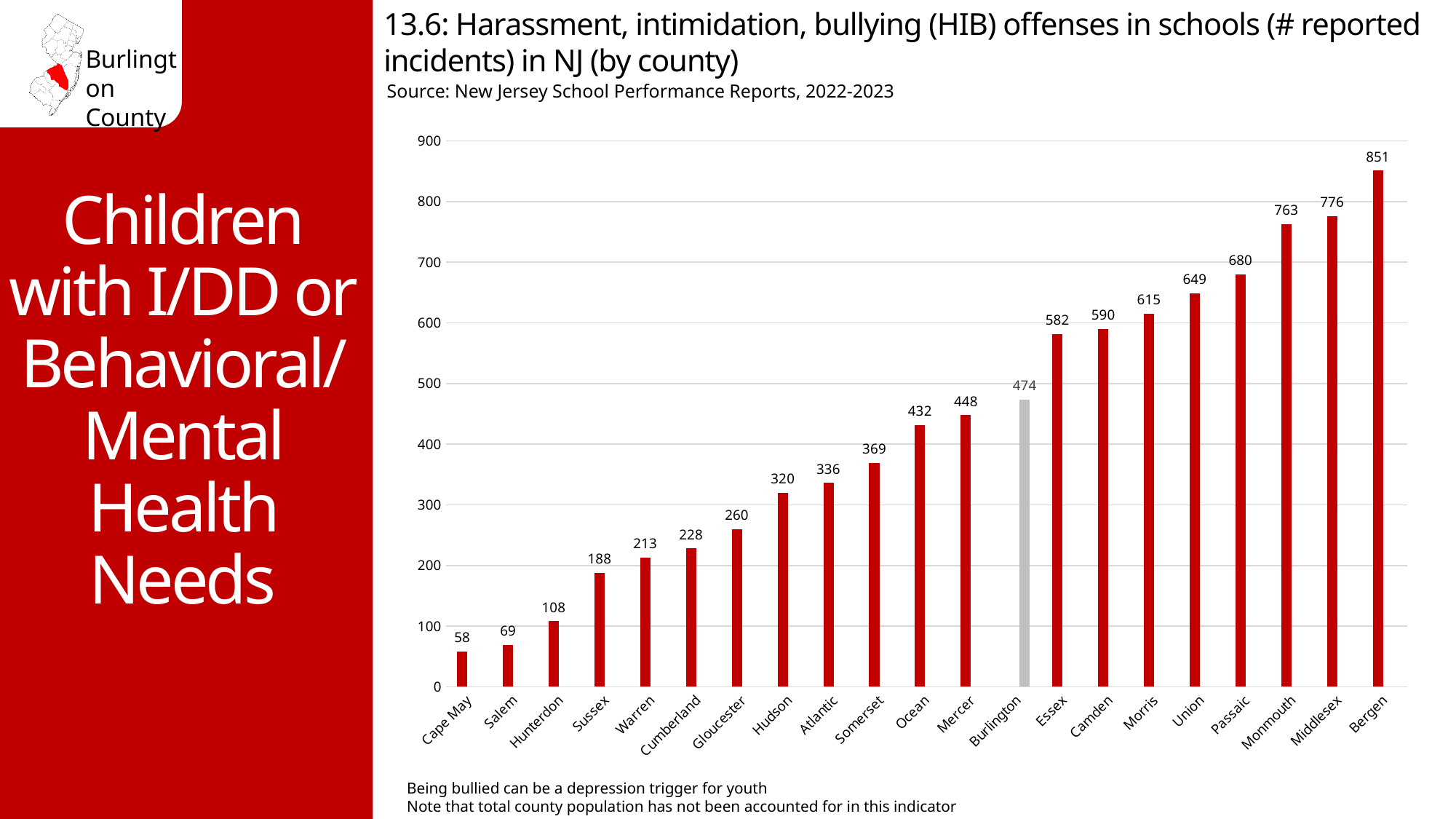
Do the values rise or fall moving from left to right along the x axis? Rise Which county's bar is coloured grey instead of red? Burlington Which county has the lowest number of reported HIB incidents? Cape May What is the value shown for Hudson? 320 How many counties are shown on the chart? 21 What is the difference between the values for Bergen and Cape May? 793 How many reported HIB incidents does the chart show for Burlington? 474 Which county has the highest number of reported HIB incidents? Bergen Which county has more reported incidents, Monmouth or Middlesex? Middlesex Is the value for Passaic greater or less than 700? less What is the difference between the values for Essex and Burlington? 108 What kind of chart is shown on the slide? Bar chart